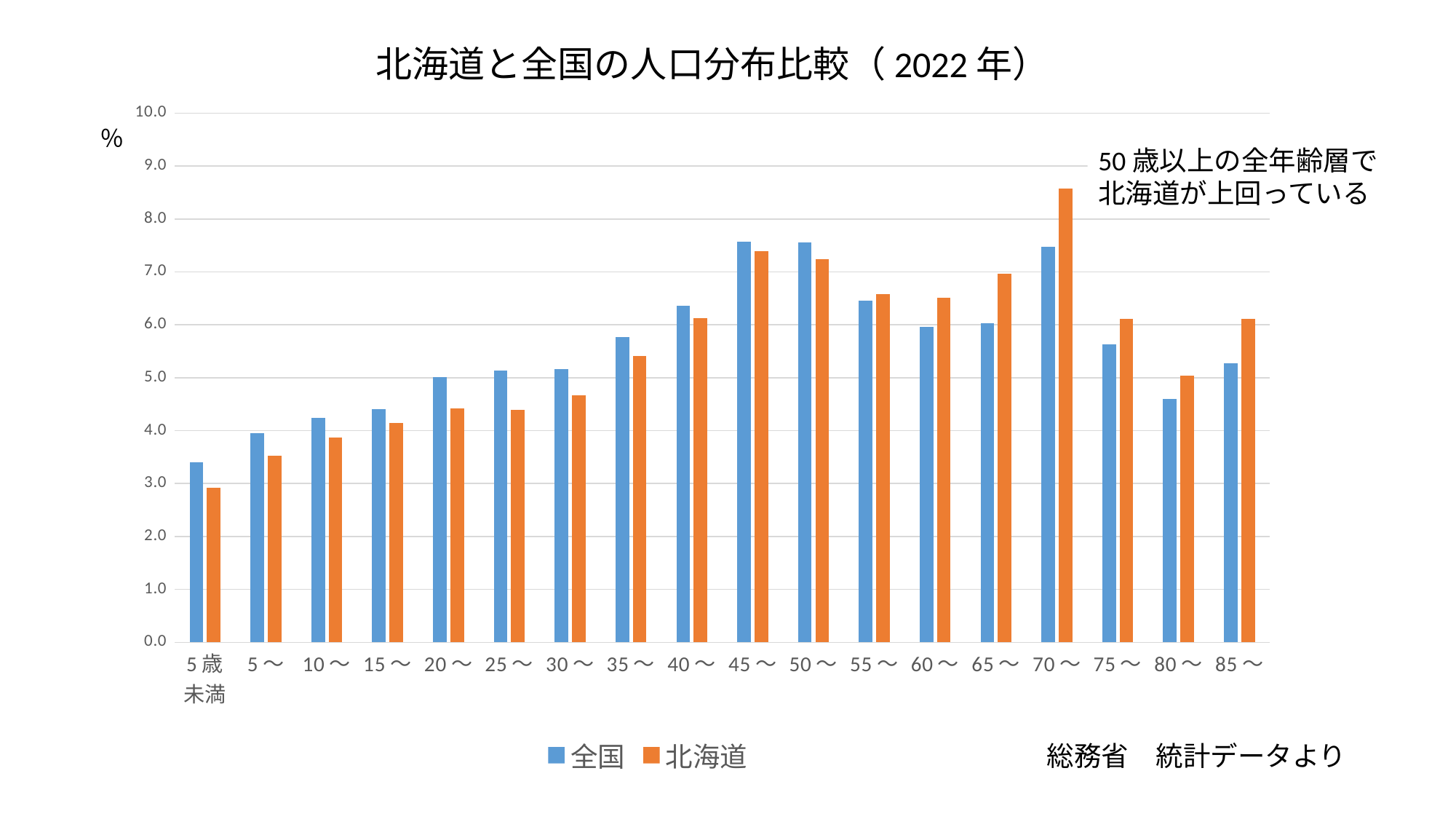
Is the value for 北海道 at 5歳未満 greater or less than 3.0? less How many age categories are shown on the x axis? 18 What kind of chart is shown on the slide? bar chart Is the value for 全国 at 80～ greater or less than 5.0? less How many series does the legend list? 2 Which age category has the highest value for 北海道? 70～ Which age category has the lowest value for 全国? 5歳未満 Is the value for 全国 at 40～ greater or less than 6.0? greater At 70～, which series has the larger value, 全国 or 北海道? 北海道 At 35～, which series has the larger value, 全国 or 北海道? 全国 What is the title of the chart? 北海道と全国の人口分布比較（2022年）